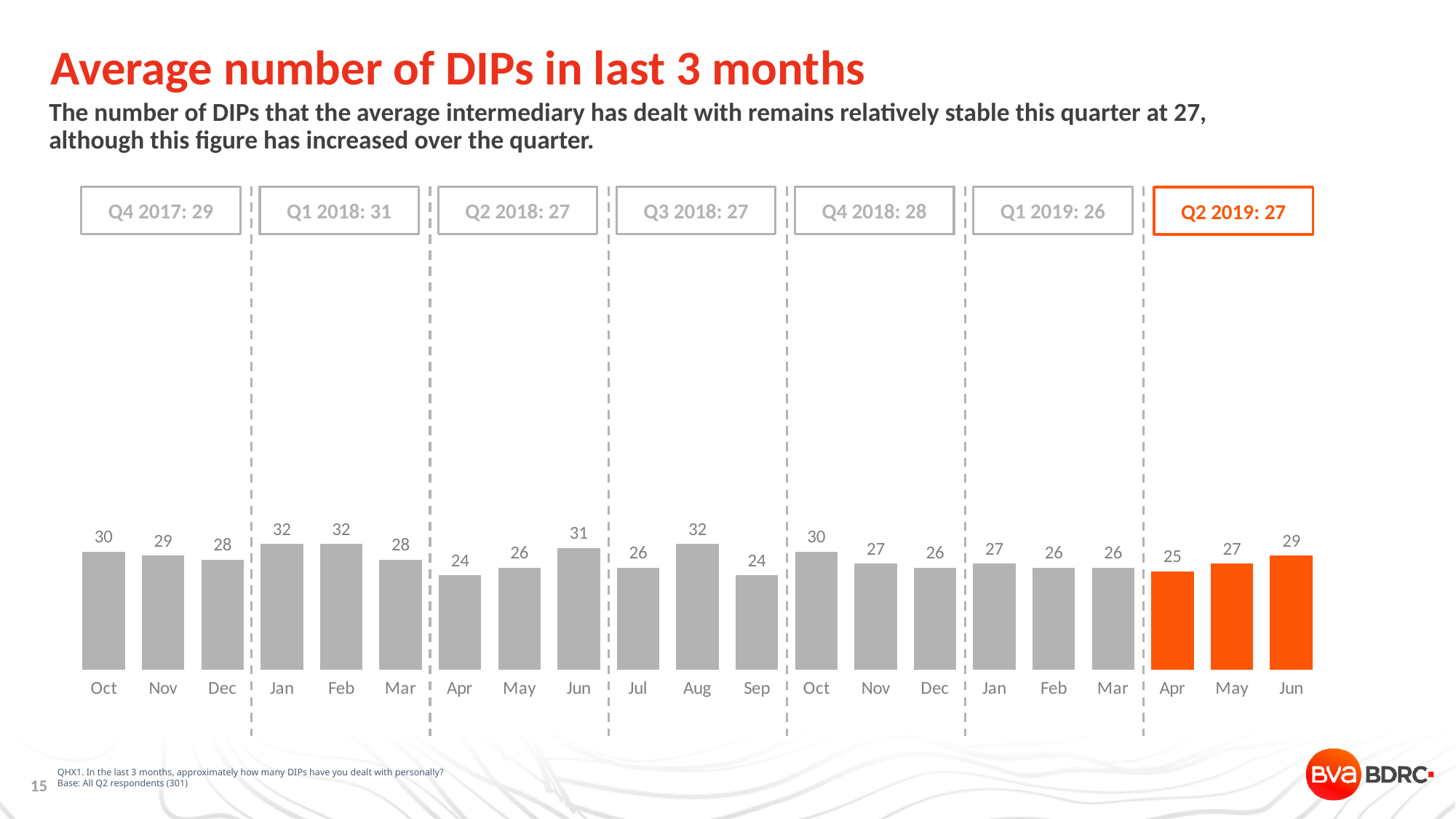
What is the value for Aug in Q3 2018? 32 What is the value for Jun in Q2 2019? 29 What is the lowest monthly value shown on the chart? 24 What is the value for Apr in Q2 2019? 25 What kind of chart is shown on the slide? Bar chart What is the difference between the Jun and Apr values in Q2 2019? 4 Which quarter's bars are coloured orange? Q2 2019 What quarterly average is shown in the box for Q1 2018? 31 How many monthly bars are plotted on the chart? 21 Do the values rise or fall across the three months of Q2 2019? Rise Which is larger, the value for Aug 2018 or the value for Sep 2018? Aug 2018 What is the highest monthly value shown on the chart? 32